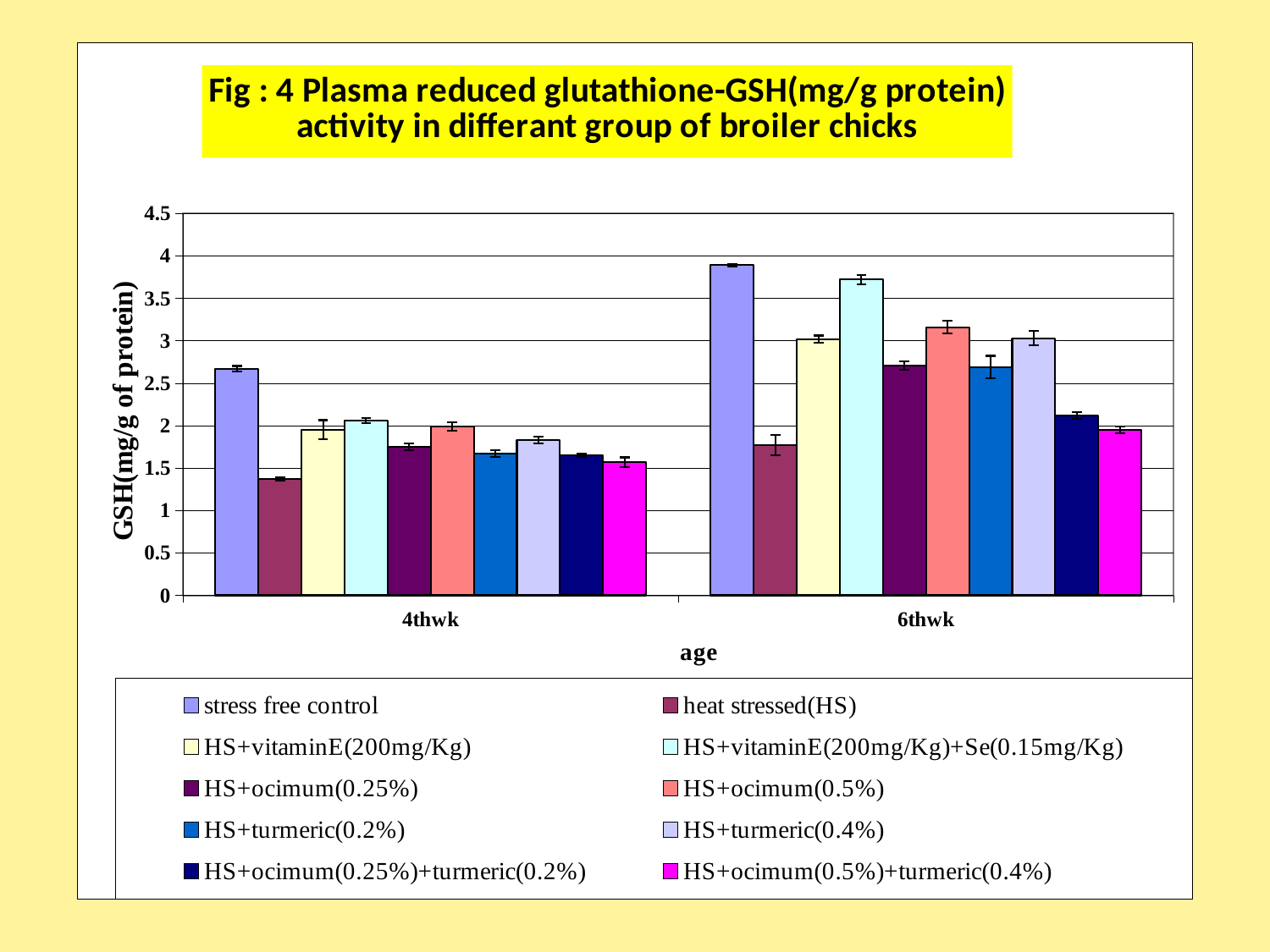
At 6thwk, which is larger: HS+vitaminE(200mg/Kg) or HS+vitaminE(200mg/Kg)+Se(0.15mg/Kg)? HS+vitaminE(200mg/Kg)+Se(0.15mg/Kg) Does the value for stress free control rise or fall from 4thwk to 6thwk? rise How many series does the legend list? 10 Which group has the highest GSH value at 4thwk? stress free control How many age categories are shown on the x axis? 2 Which group has the lowest GSH value at 4thwk? heat stressed(HS) What is the label of the y axis? GSH(mg/g of protein) Which group has the lowest GSH value at 6thwk? heat stressed(HS) Is the value for heat stressed(HS) at 4thwk greater or less than 1.5? less Which group has the highest GSH value at 6thwk? stress free control What kind of chart is shown on the slide? bar chart Is the value for stress free control at 6thwk greater or less than 3.5? greater